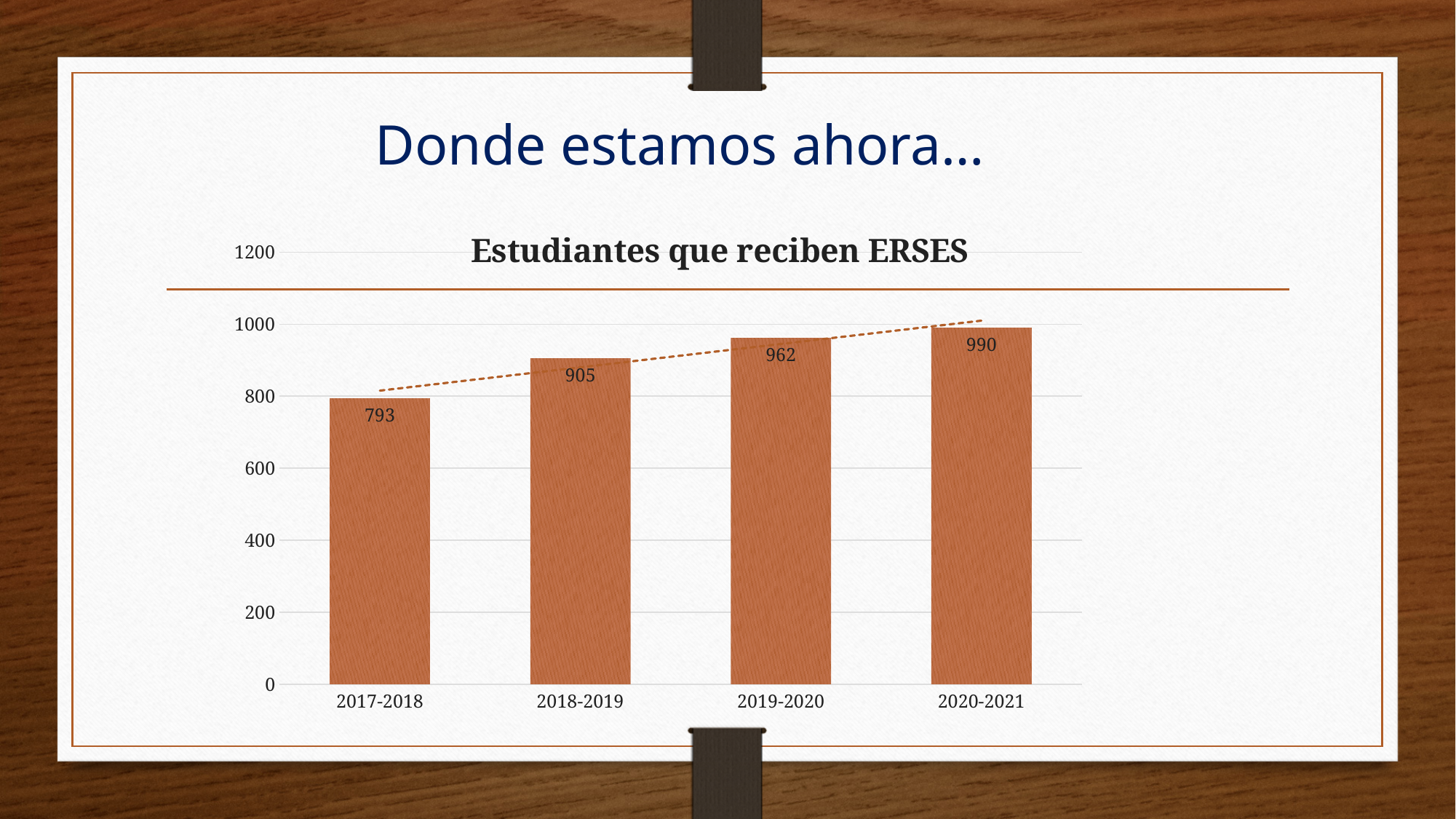
What is the value for 2017-2018? 793 Which is larger, the value for 2018-2019 or the value for 2019-2020? 2019-2020 What is the difference between the values for 2020-2021 and 2017-2018? 197 Do the values rise or fall from 2017-2018 to 2020-2021? Rise How many school years are shown on the chart? 4 What kind of chart is shown on the slide? Bar chart What is the value for 2018-2019? 905 Which school year has the lowest value? 2017-2018 What is the value for 2020-2021? 990 What is the difference between the values for 2019-2020 and 2018-2019? 57 What is the value for 2019-2020? 962 Which school year has the highest value? 2020-2021